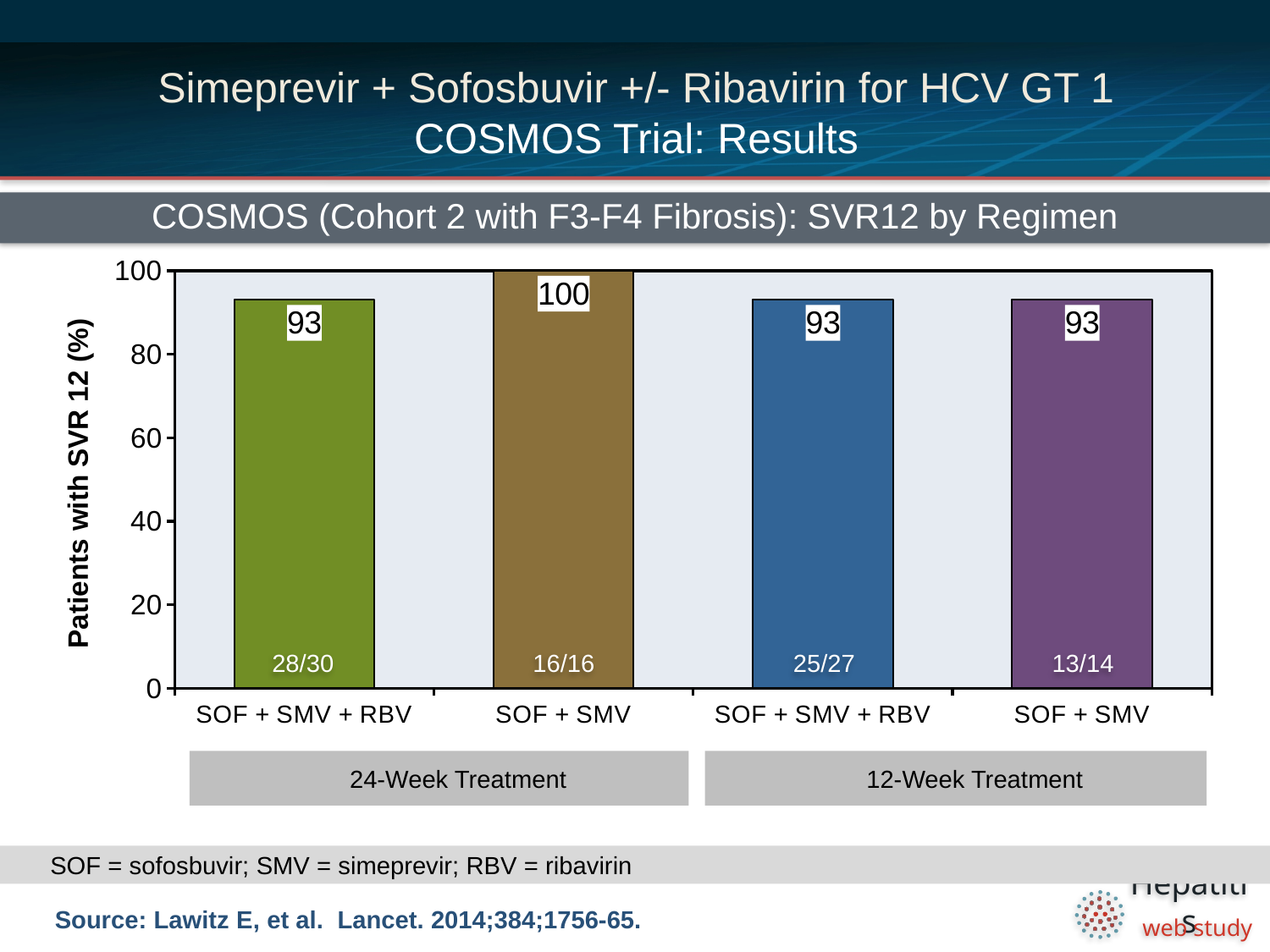
Which regimen and treatment duration has the highest SVR12 value? SOF + SMV, 24-Week Treatment What is the difference between the SVR12 value for SOF + SMV (24-Week) and SOF + SMV + RBV (24-Week)? 7 What fraction of patients is shown inside the SOF + SMV + RBV bar in the 24-Week Treatment group? 28/30 Which is larger: the SVR12 value for SOF + SMV in the 24-Week group or SOF + SMV in the 12-Week group? SOF + SMV in the 24-Week group What is the label of the y-axis? Patients with SVR 12 (%) What is the SVR12 value for SOF + SMV + RBV in the 12-Week Treatment group? 93 What type of chart is shown on the slide? Bar chart How many bars are shown in the chart? 4 What is the SVR12 value for SOF + SMV in the 24-Week Treatment group? 100 What fraction of patients is shown inside the SOF + SMV bar in the 12-Week Treatment group? 13/14 Is the SVR12 value for SOF + SMV + RBV in the 12-Week Treatment group greater or less than 80? greater What is the SVR12 value for SOF + SMV in the 12-Week Treatment group? 93